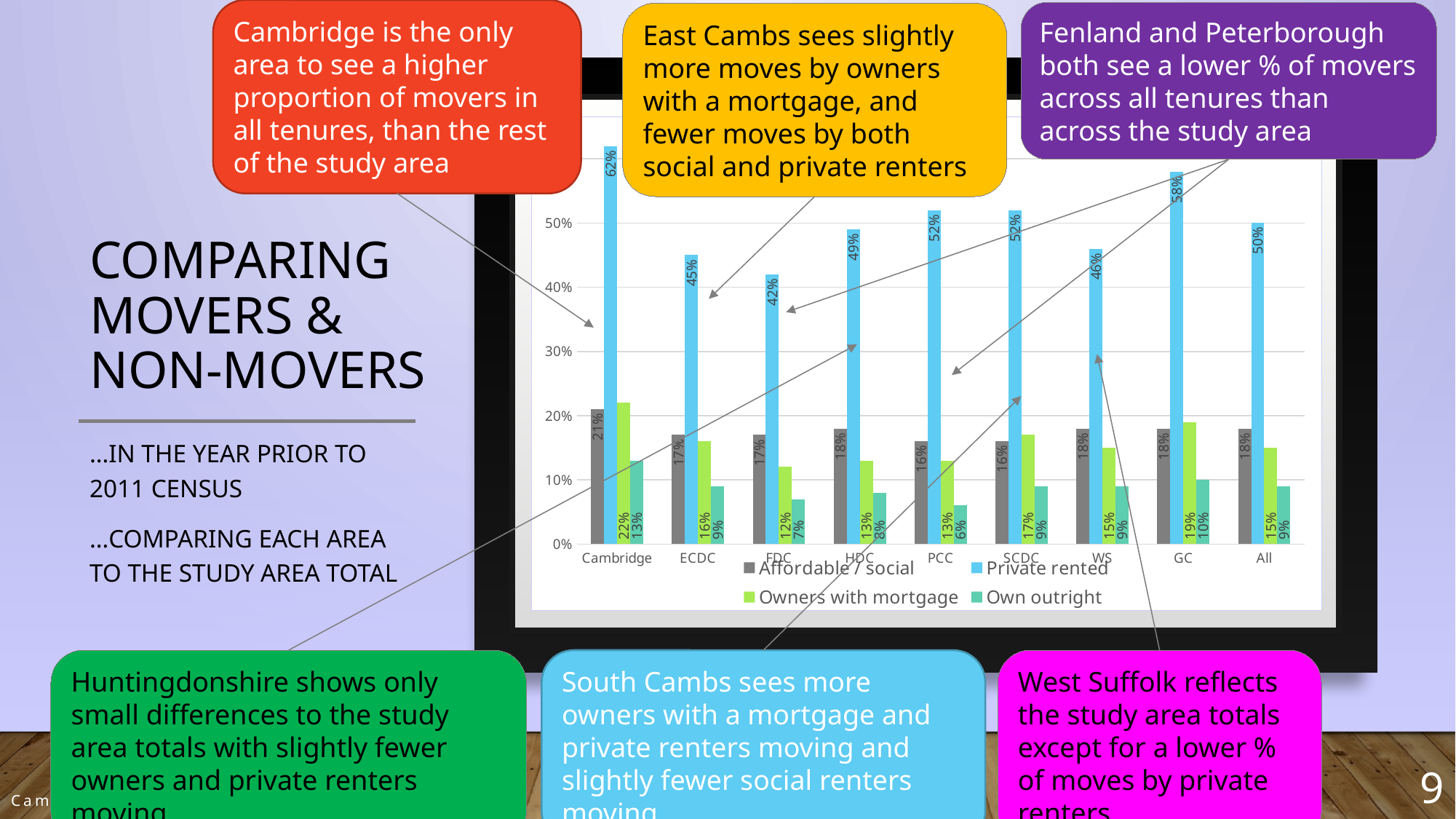
What is the Own outright value for PCC? 6% What kind of chart is shown on the slide? bar chart What is the difference between the Private rented values for Cambridge and All? 12% What is the Affordable / social value for Cambridge? 21% What is the Owners with mortgage value for GC? 19% Which is larger, the Owners with mortgage value for SCDC or for HDC? SCDC Which category has the highest Private rented value? Cambridge Is the Private rented value for WS greater or less than 40%? greater What is the Private rented value for Cambridge? 62% How many categories are shown on the x axis of the chart? 9 Which category has the lowest Private rented value? FDC How many series does the chart legend list? 4